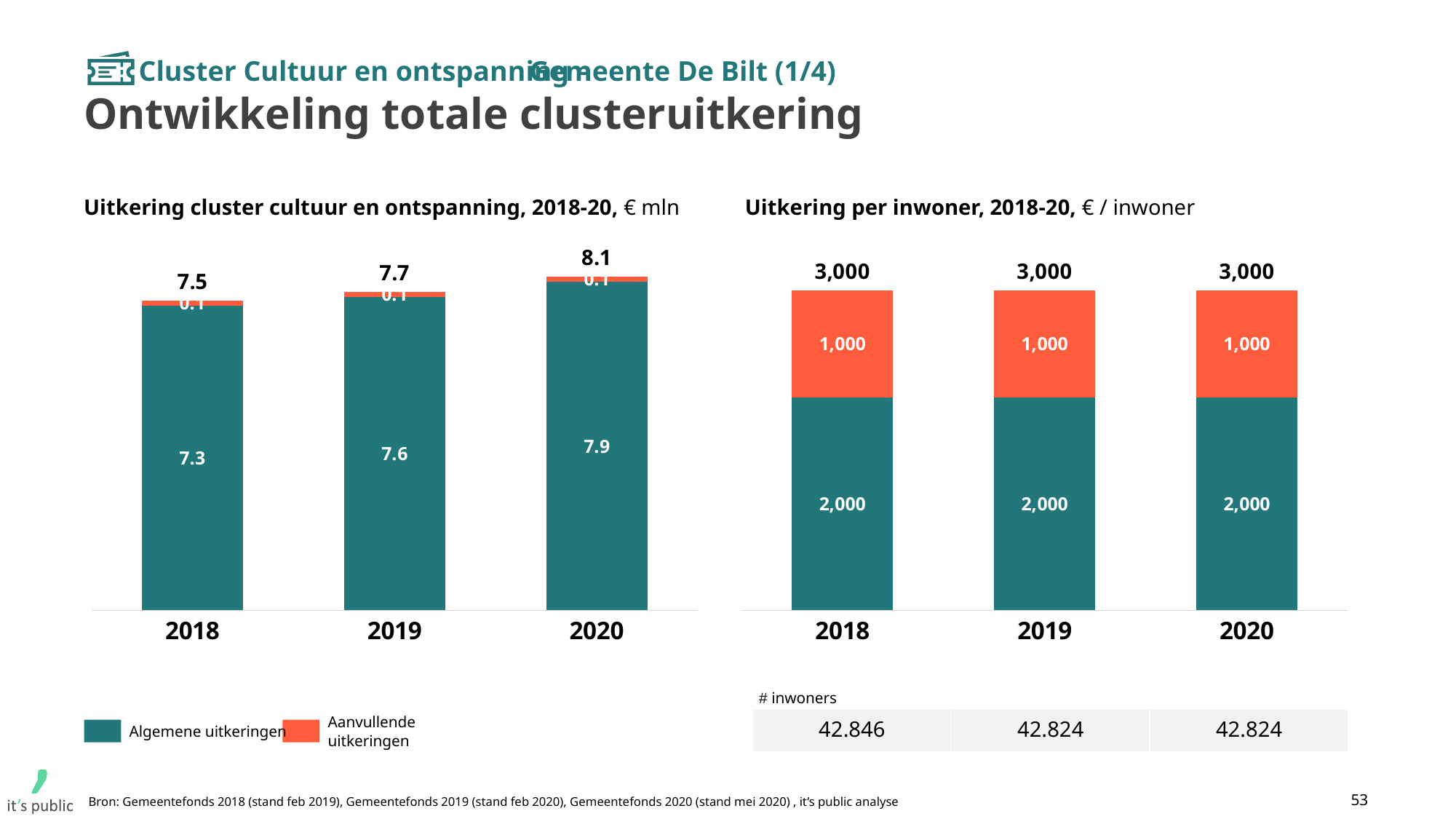
In the chart 'Uitkering cluster cultuur en ontspanning, 2018-20', what is the total of the stacked bar for 2019? 7.7 In the chart 'Uitkering per inwoner, 2018-20', what is the total of the stacked bar for 2020? 3,000 In the chart 'Uitkering per inwoner, 2018-20', is the Algemene uitkeringen value for 2018 larger or smaller than the Aanvullende uitkeringen value for 2018? larger In the chart 'Uitkering per inwoner, 2018-20', what is the value of Aanvullende uitkeringen for 2019? 1,000 In the chart 'Uitkering cluster cultuur en ontspanning, 2018-20', what is the difference between the Algemene uitkeringen values for 2020 and 2018? 0.6 What kind of chart is 'Uitkering cluster cultuur en ontspanning, 2018-20'? stacked bar chart In the chart 'Uitkering cluster cultuur en ontspanning, 2018-20', what is the value of Algemene uitkeringen for 2020? 7.9 In the chart 'Uitkering cluster cultuur en ontspanning, 2018-20', do the totals rise or fall from 2018 to 2020? rise How many series does the legend on the slide list? 2 In the chart 'Uitkering cluster cultuur en ontspanning, 2018-20', what is the total of the stacked bar for 2018? 7.5 In the chart 'Uitkering cluster cultuur en ontspanning, 2018-20', which year has the lowest value for Algemene uitkeringen? 2018 In the chart 'Uitkering cluster cultuur en ontspanning, 2018-20', which year has the highest total? 2020